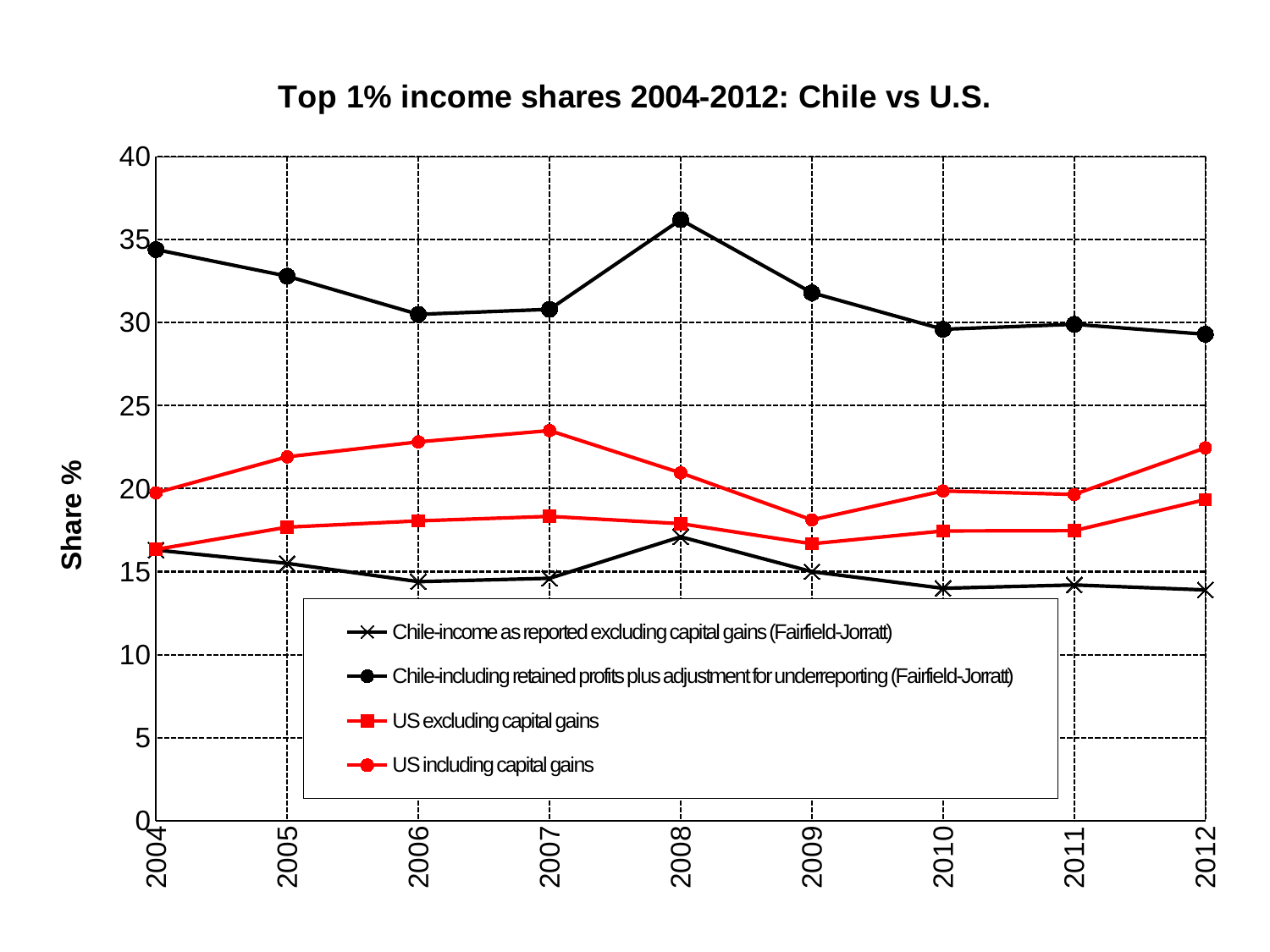
In which year does the 'Chile-including retained profits plus adjustment for underreporting (Fairfield-Jorratt)' series reach its highest value? 2008 What kind of chart is shown on the slide? line chart Is the value for 'Chile-income as reported excluding capital gains (Fairfield-Jorratt)' in 2012 greater or less than 15? less What is the title of the chart? Top 1% income shares 2004-2012: Chile vs U.S. Is the value for 'US excluding capital gains' in 2004 greater or less than 20? less Is the value for 'Chile-including retained profits plus adjustment for underreporting (Fairfield-Jorratt)' in 2008 greater or less than 35? greater How many years are plotted along the x axis? 9 How many series does the legend list? 4 In 2004, which series has the higher value: 'Chile-including retained profits plus adjustment for underreporting (Fairfield-Jorratt)' or 'US including capital gains'? Chile-including retained profits plus adjustment for underreporting (Fairfield-Jorratt) In which year does the 'Chile-income as reported excluding capital gains (Fairfield-Jorratt)' series reach its highest value? 2008 In which year does the 'US including capital gains' series reach its lowest value? 2009 Does the 'Chile-including retained profits plus adjustment for underreporting (Fairfield-Jorratt)' series rise or fall from 2008 to 2010? fall